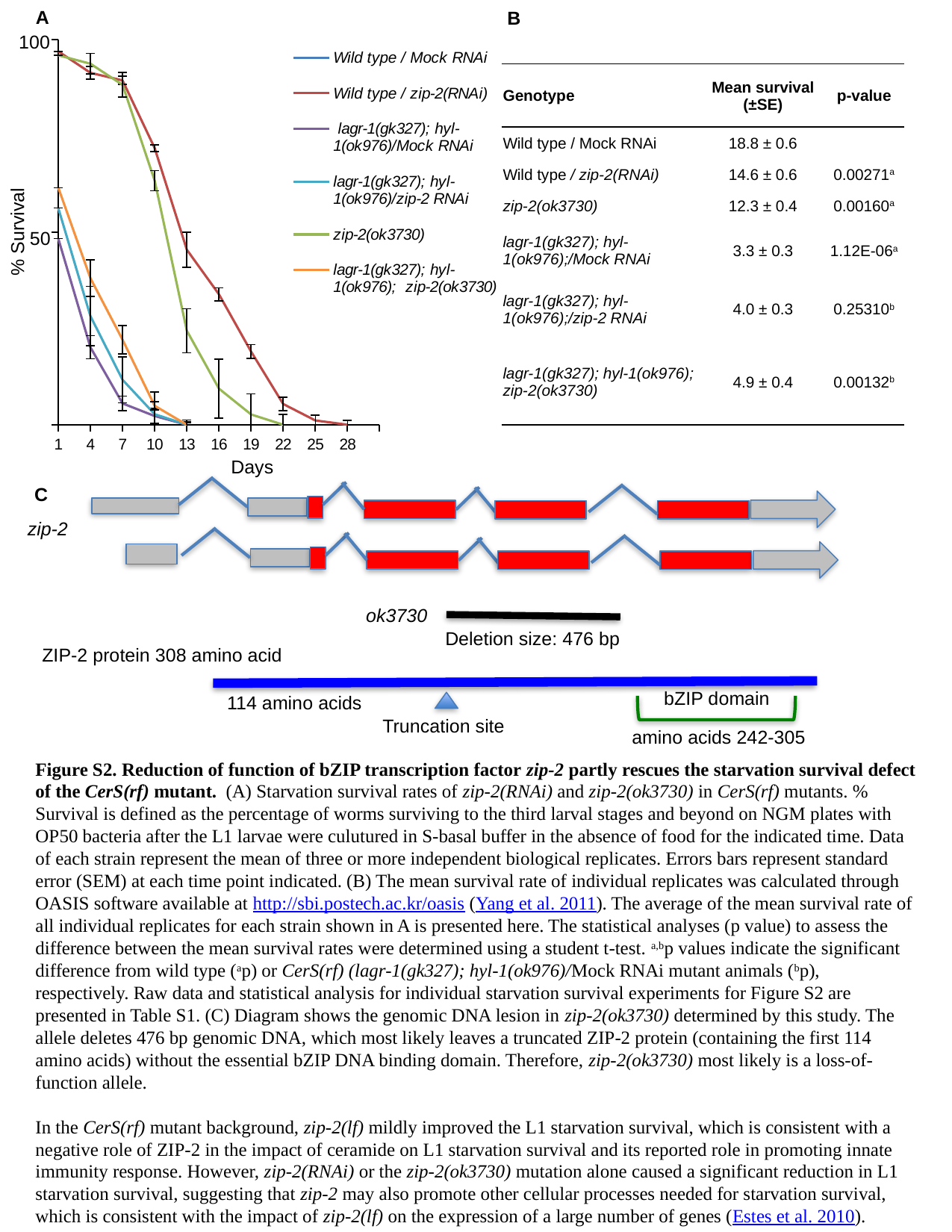
In the chart in panel A, which series has the higher value at day 1: Wild type / Mock RNAi or lagr-1(gk327); hyl-1(ok976)/Mock RNAi? Wild type / Mock RNAi What kind of chart is panel A? line chart In the chart in panel A, is the value for Wild type / zip-2(RNAi) at day 10 greater or less than 50? greater How many day values are labelled on the x axis of the chart in panel A? 10 How many series does the legend of the chart in panel A list? 6 In the chart in panel A, is the value for zip-2(ok3730) at day 16 greater or less than 50? less In the chart in panel A, is the value for lagr-1(gk327); hyl-1(ok976); zip-2(ok3730) at day 1 greater or less than 50? greater What is the x-axis label of the chart in panel A? Days In the chart in panel A, which series has the higher value at day 16: Wild type / zip-2(RNAi) or zip-2(ok3730)? Wild type / zip-2(RNAi) In the chart in panel A, do the % Survival values rise or fall as the days increase? fall